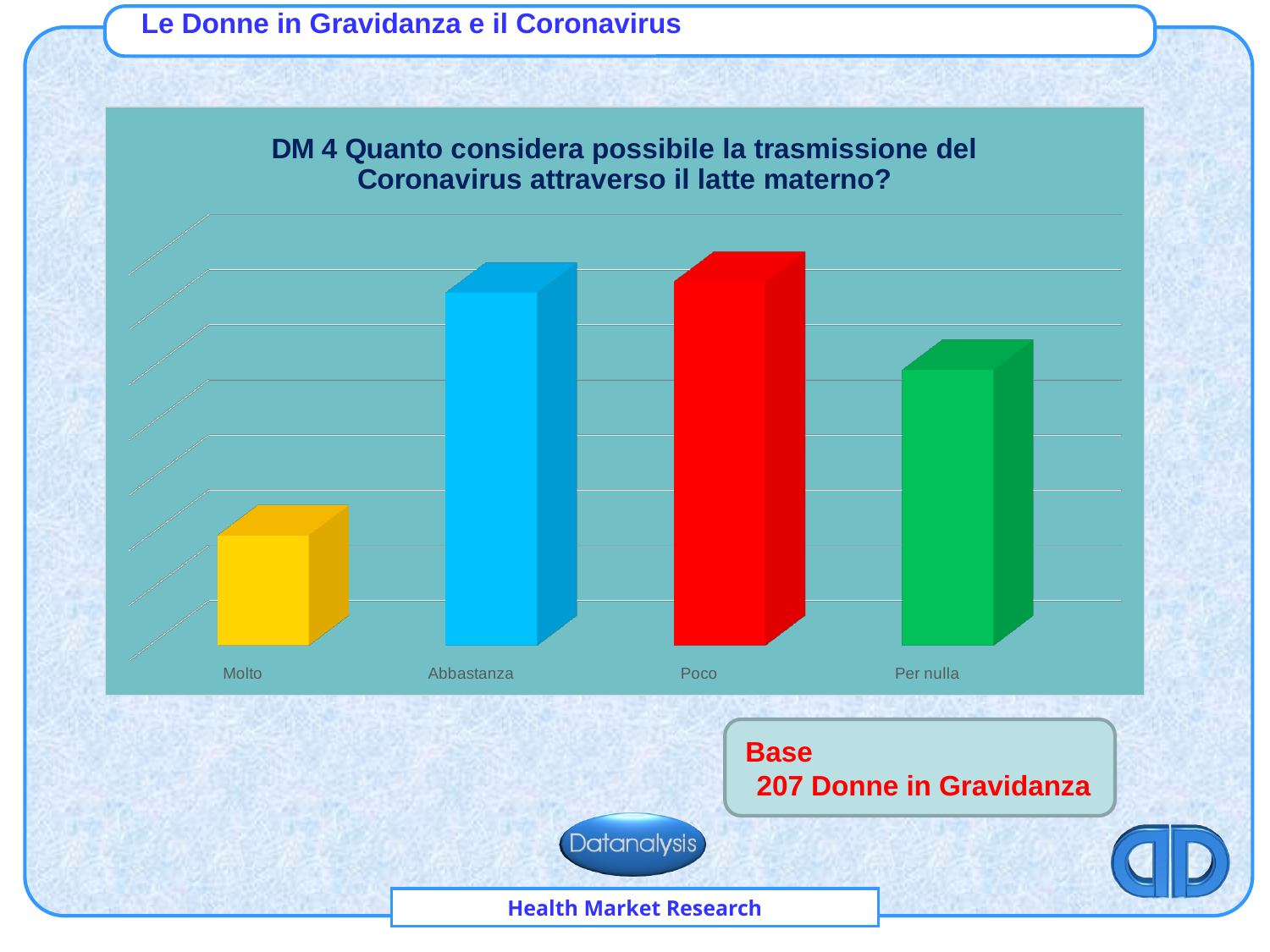
Which is larger, the value for Abbastanza or the value for Per nulla? Abbastanza How many categories are shown on the x axis of the chart? 4 Which category has the lowest bar in the chart? Molto What colour is the bar for Molto? yellow Is the bar for Abbastanza taller or shorter than the bar for Molto? taller Which is larger, the value for Per nulla or the value for Molto? Per nulla What is the title of the chart? DM 4 Quanto considera possibile la trasmissione del Coronavirus attraverso il latte materno? What kind of chart is shown on the slide? bar chart Which category is the second-lowest bar in the chart? Per nulla